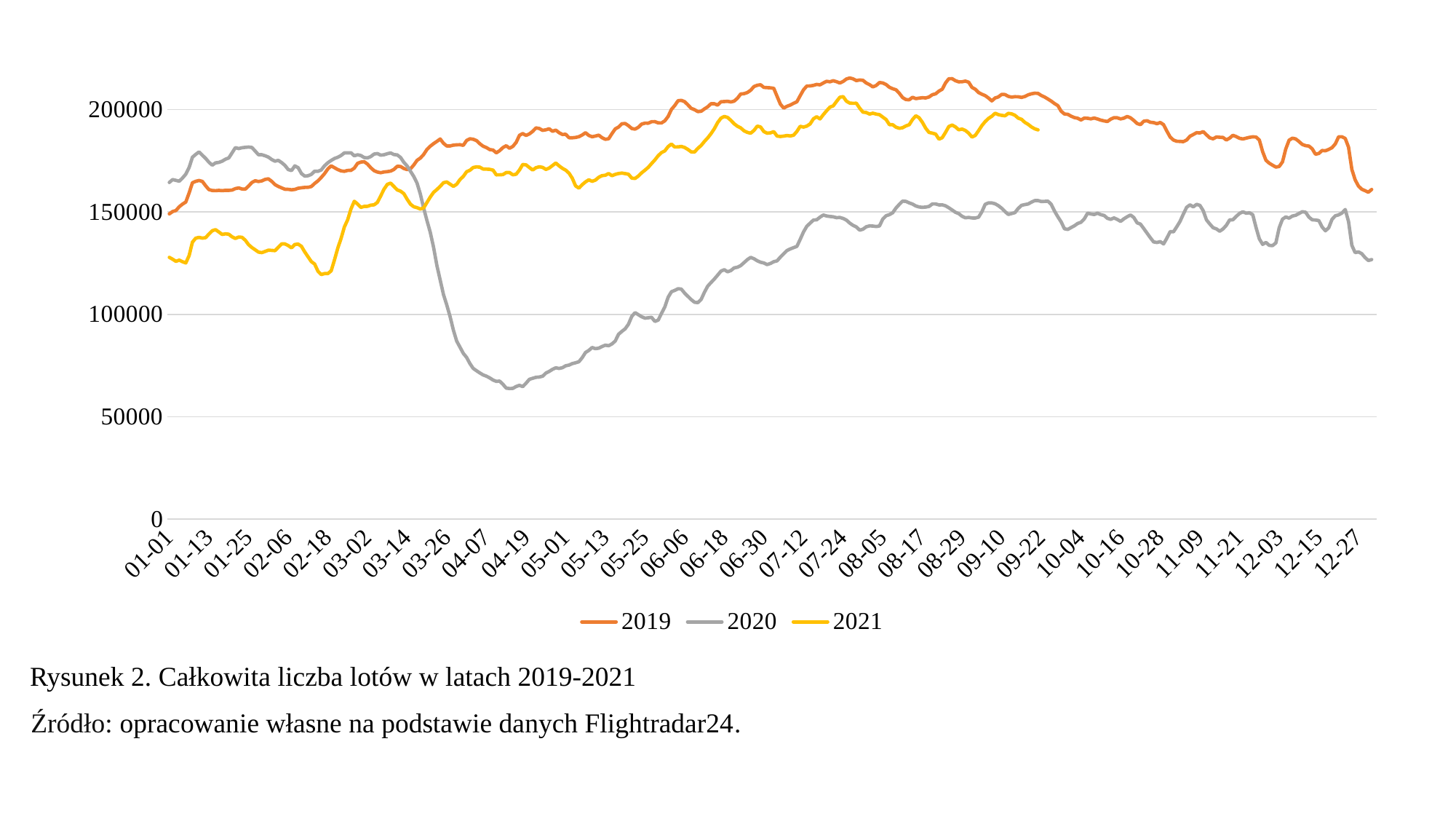
Is the value of the 2019 series at 07-24 greater or less than 200000? greater At 01-01, which series has the larger value, 2020 or 2021? 2020 Which series are listed in the legend? 2019, 2020, 2021 Is the value of the 2020 series at 04-19 greater or less than 100000? less Does the 2020 series rise or fall between 03-14 and 04-19? fall How many series does the legend list? 3 Is the value of the 2020 series at 12-27 greater or less than 150000? less What kind of chart is shown on the slide? line chart At 04-19, which series has the larger value, 2019 or 2020? 2019 What is the caption of the figure below the chart? Rysunek 2. Całkowita liczba lotów w latach 2019-2021 Which series reaches the lowest point on the chart? 2020